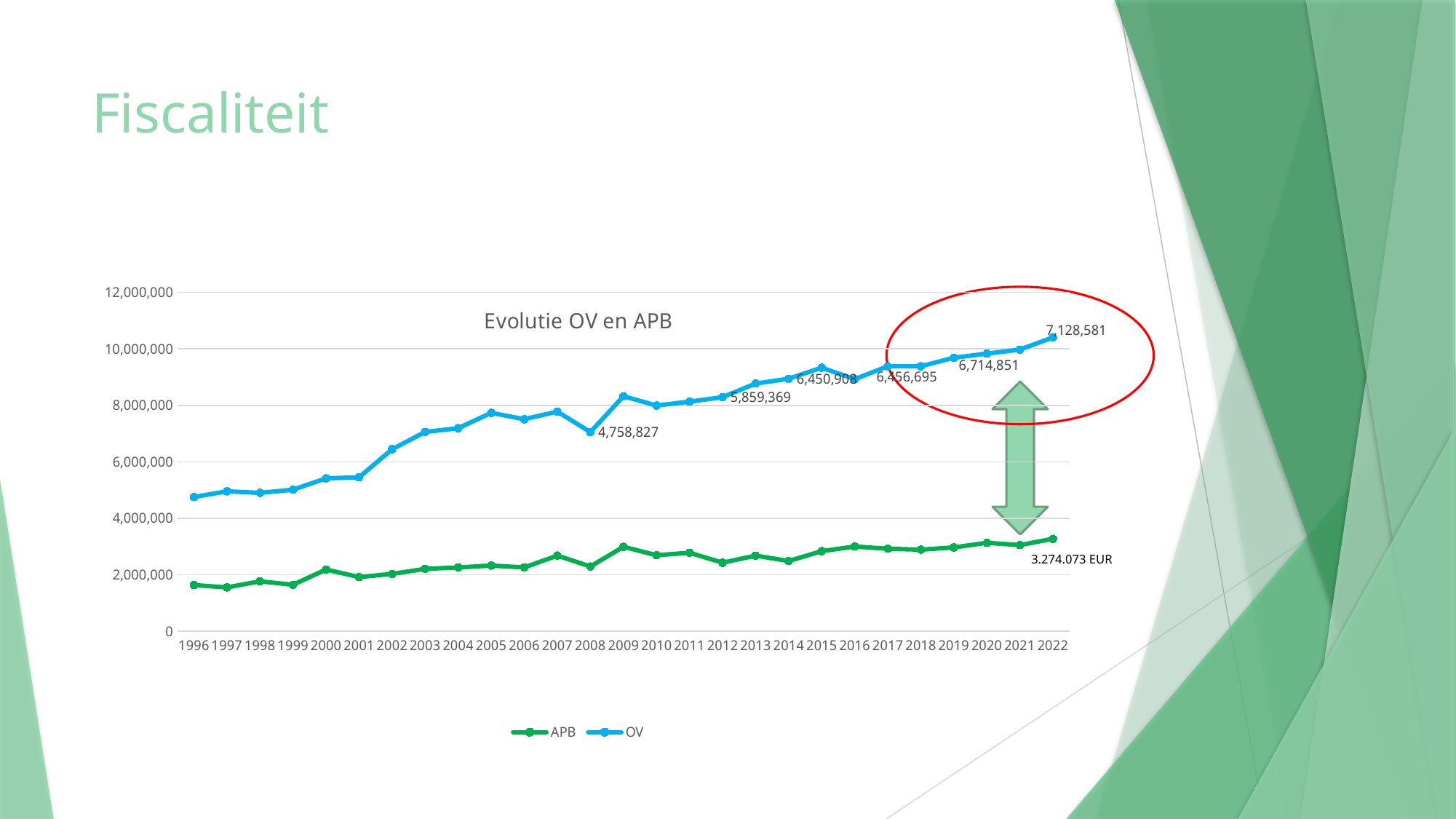
How many series does the legend list? 2 Is the value for OV in 1996 greater or less than 6,000,000? less What is the title of the chart? Evolutie OV en APB Which series is larger in 2010, OV or APB? OV What value is annotated next to the APB series at 2022? 3.274.073 EUR How many years are shown on the x axis? 27 In which year is the OV series at its lowest? 1996 In which year is the OV series at its highest? 2022 What kind of chart is shown on the slide? line chart Does the OV series generally rise or fall from 1996 to 2022? rise Is the value for APB in 2009 greater or less than 2,000,000? greater